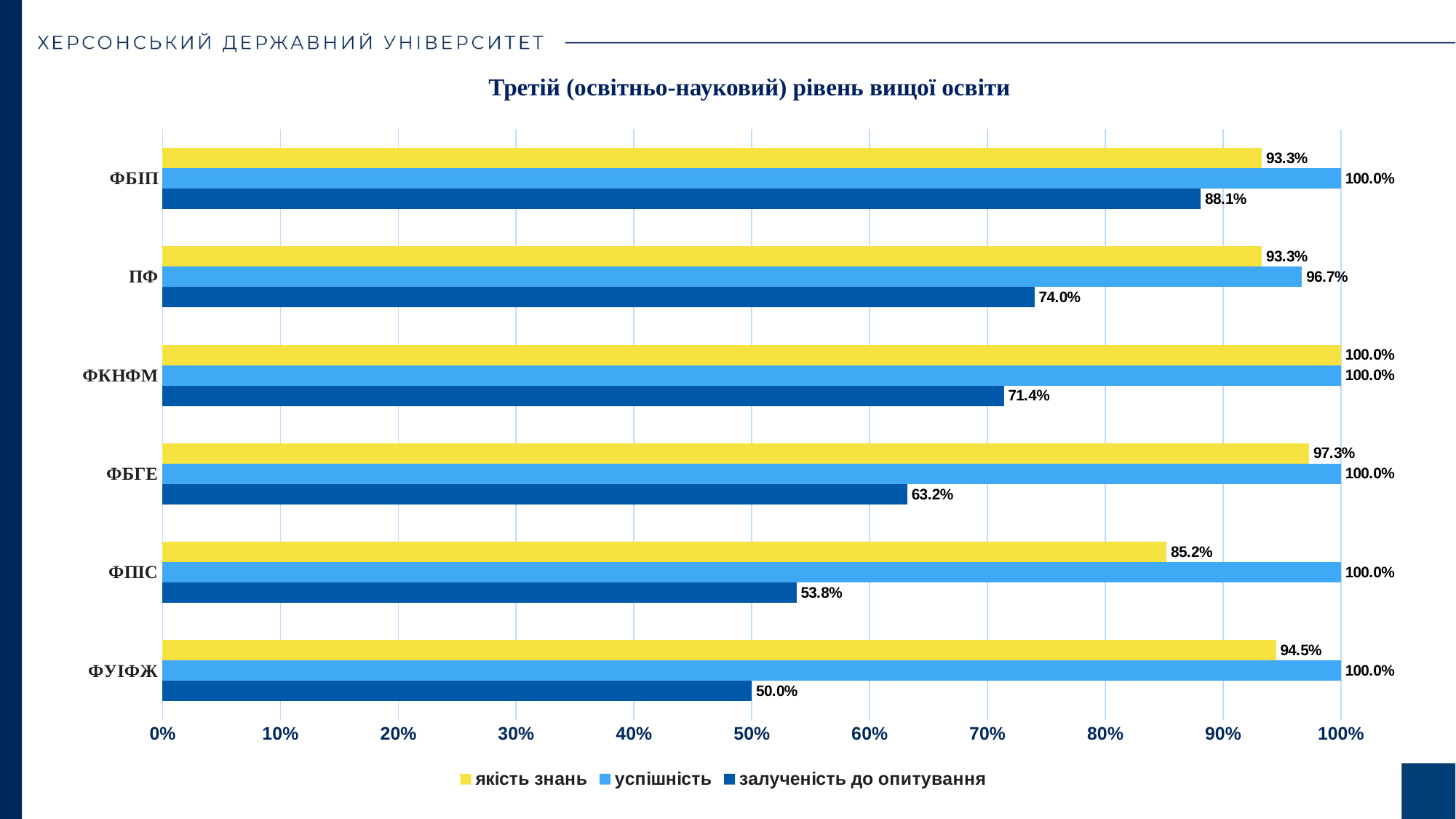
What is the value of залученість до опитування for ФБІП? 88.1% What is the difference between залученість до опитування for ФБІП and for ПФ? 14.1% Which series is shown in yellow? якість знань What is the value of успішність for ПФ? 96.7% What is the value of якість знань for ФПІС? 85.2% How many categories (faculties) are shown on the chart? 6 What type of chart is shown on the slide? bar chart How many series does the legend list? 3 Which category has the highest value for якість знань? ФКНФМ Which is larger: якість знань for ФБГЕ or якість знань for ФУІФЖ? ФБГЕ Which category has the lowest value for залученість до опитування? ФУІФЖ What is the title of the chart? Третій (освітньо-науковий) рівень вищої освіти